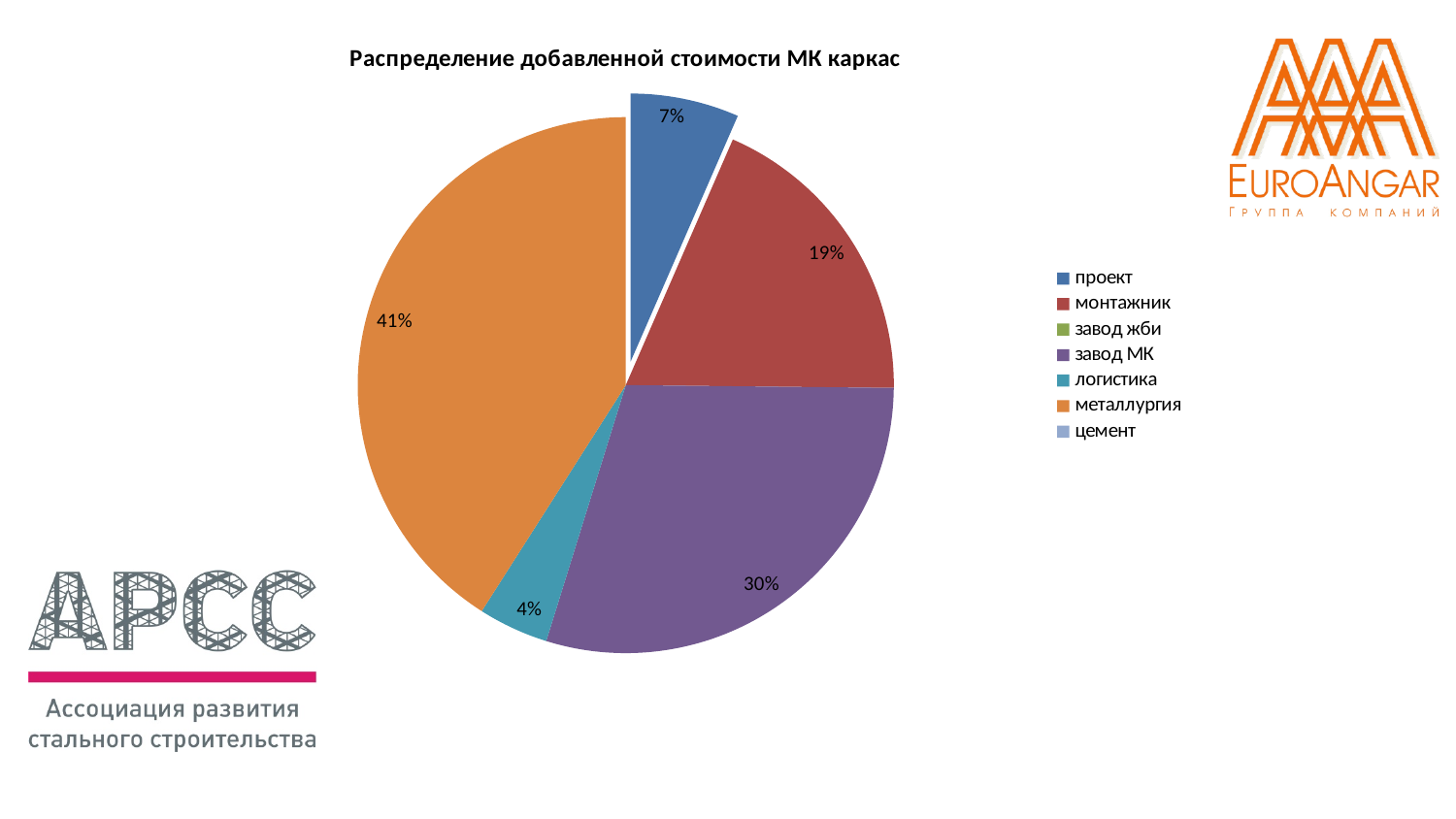
What share of the pie does металлургия have? 41% What type of chart is shown on the slide? pie chart Which category has the largest slice of the pie? металлургия How many entries does the legend list? 7 What share of the pie does завод МК have? 30% What share of the pie does проект have? 7% What is the title of the chart? Распределение добавленной стоимости МК каркас What share of the pie does логистика have? 4% What share of the pie does монтажник have? 19% What is the difference in percentage points between металлургия and завод МК? 11 Which labelled slice is the smallest in the pie? логистика Which is larger, the slice for монтажник or the slice for проект? монтажник